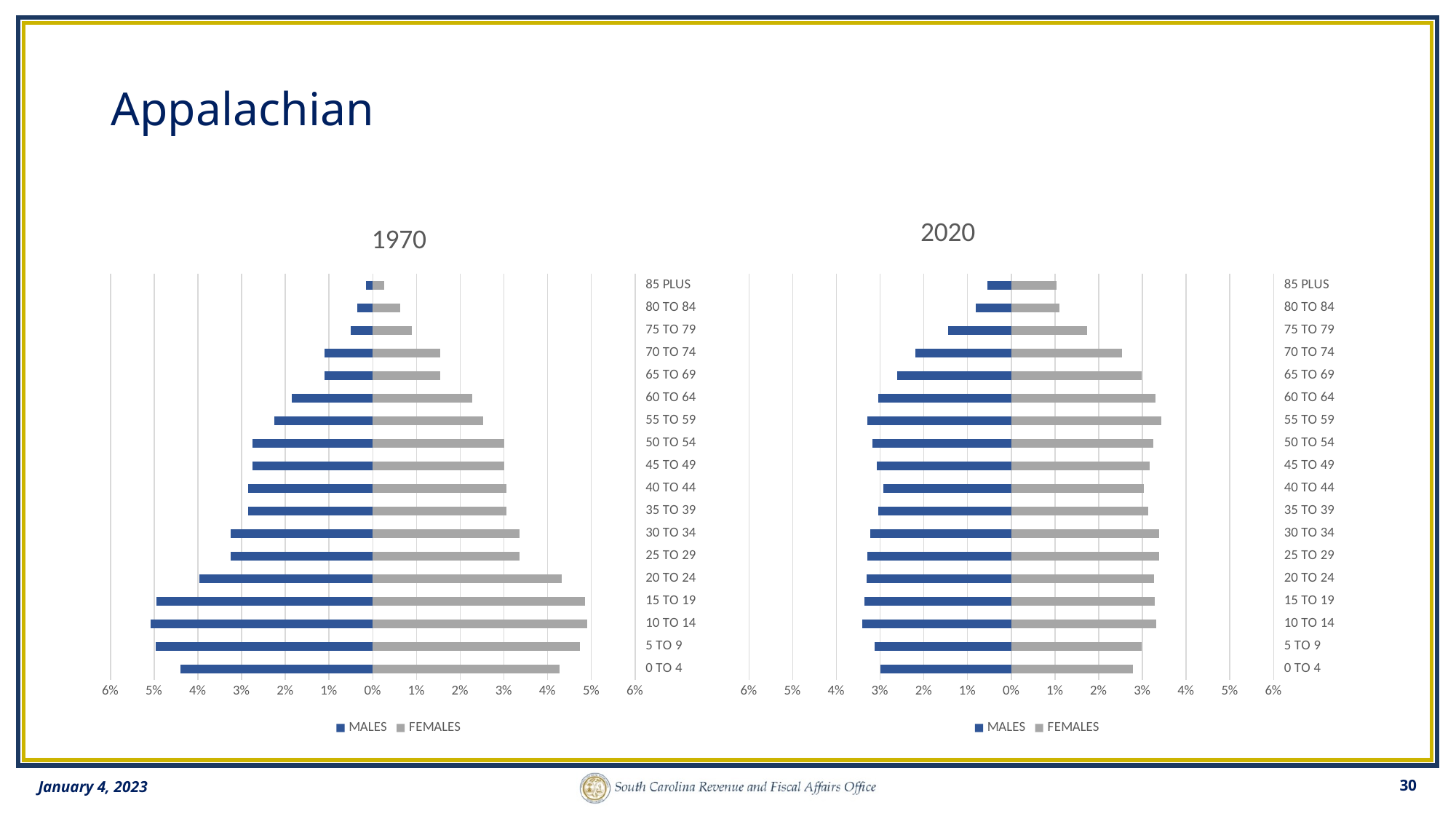
In the 1970 chart, which age group has the smallest MALES value? 85 PLUS In the 1970 chart, is the MALES value for 60 TO 64 greater or less than 2%? less In the 2020 chart, is the 85 PLUS value larger for MALES or FEMALES? FEMALES In the 2020 chart, is the MALES value for 65 TO 69 greater or less than 2%? greater Is the MALES value for 0 TO 4 larger in the 1970 chart or the 2020 chart? 1970 In the 2020 chart, is the MALES value for 85 PLUS greater or less than 1%? less In the 2020 chart, which age group has the smallest MALES value? 85 PLUS How many age groups are shown in the 2020 chart? 18 In the 1970 chart, do the MALES bars generally get longer or shorter moving from 40 TO 44 up to 85 PLUS? shorter What kind of chart is the 1970 chart? bar chart How many series does the legend of the 1970 chart list? 2